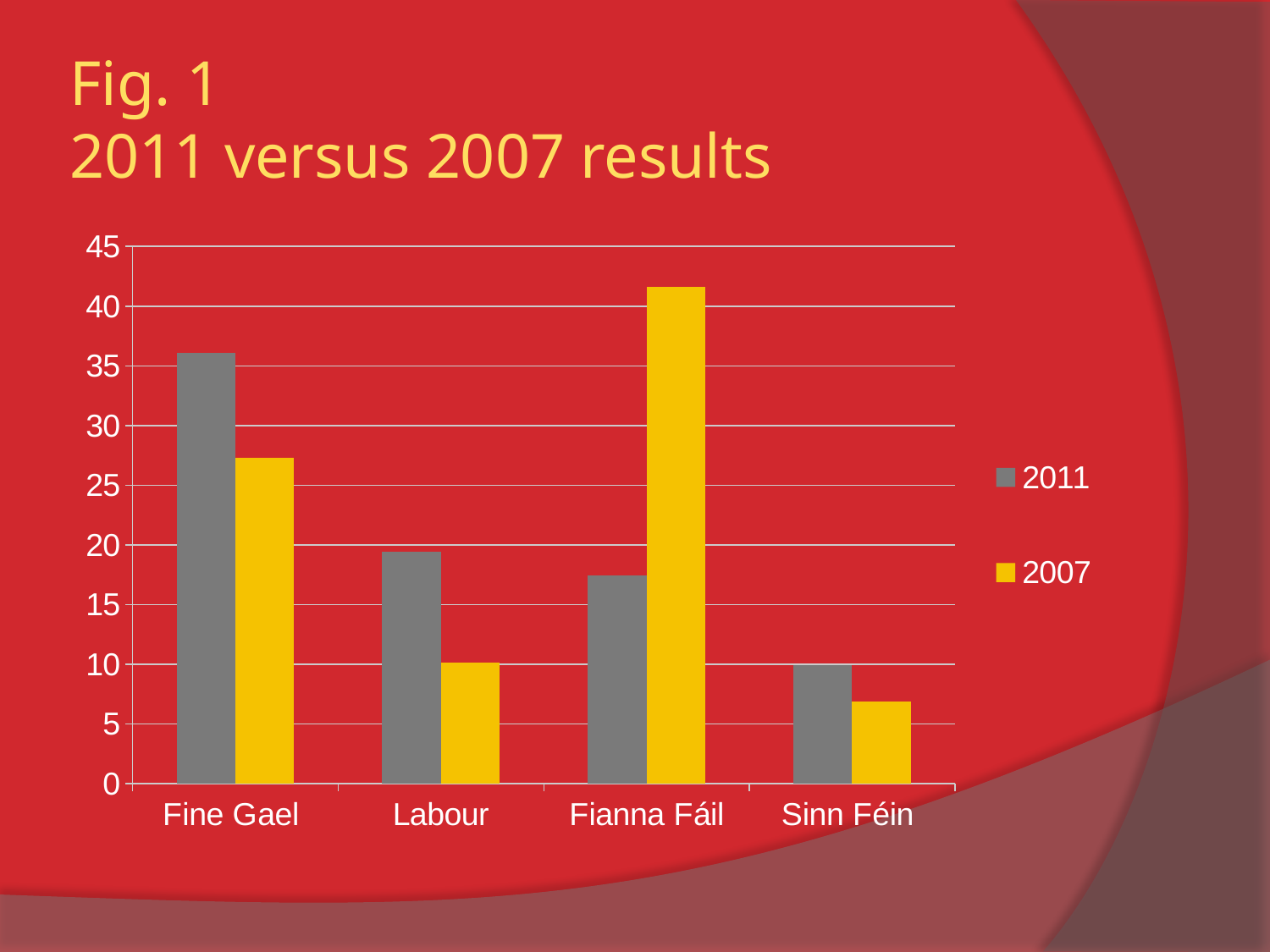
Is the 2007 value for Fianna Fáil greater or less than 40? greater How many series does the legend list? 2 Which party has the lowest value for 2007? Sinn Féin Is the 2007 value for Sinn Féin greater or less than 10? less Is the 2011 value for Fine Gael greater or less than 30? greater What kind of chart is shown on the slide? bar chart For Labour, which is larger: the 2011 value or the 2007 value? 2011 Which party has the lowest value for 2011? Sinn Féin For Fianna Fáil, which is larger: the 2011 value or the 2007 value? 2007 Which party has the highest value for 2007? Fianna Fáil Which party has the highest value for 2011? Fine Gael How many parties are shown on the x axis of the chart? 4